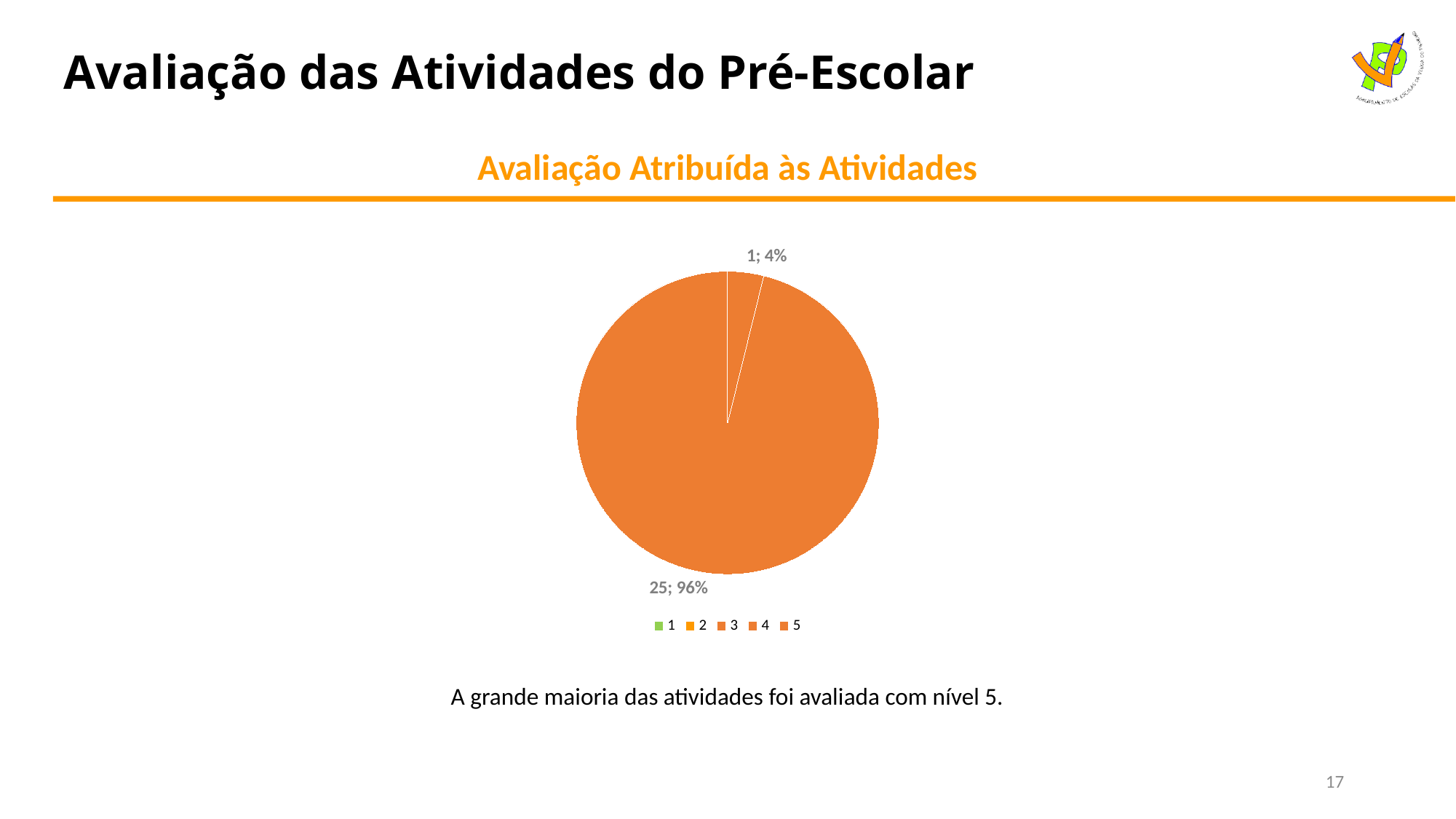
How many entries does the chart legend list? 5 What are the entries listed in the chart legend? 1, 2, 3, 4, 5 What is the difference in the number of activities between the largest slice and the smallest slice? 24 Which evaluation level was assigned to the great majority of activities? 5 What is the title of the chart? Avaliação Atribuída às Atividades What share of the pie does the smallest slice represent? 4% How many activities are in the smallest slice of the pie? 1 What is the data label on the largest slice of the pie? 25; 96% What share of the pie does the largest slice represent? 96% How many slices are visible in the pie chart? 2 What is the total number of activities represented in the pie chart? 26 What kind of chart is shown on the slide? pie chart